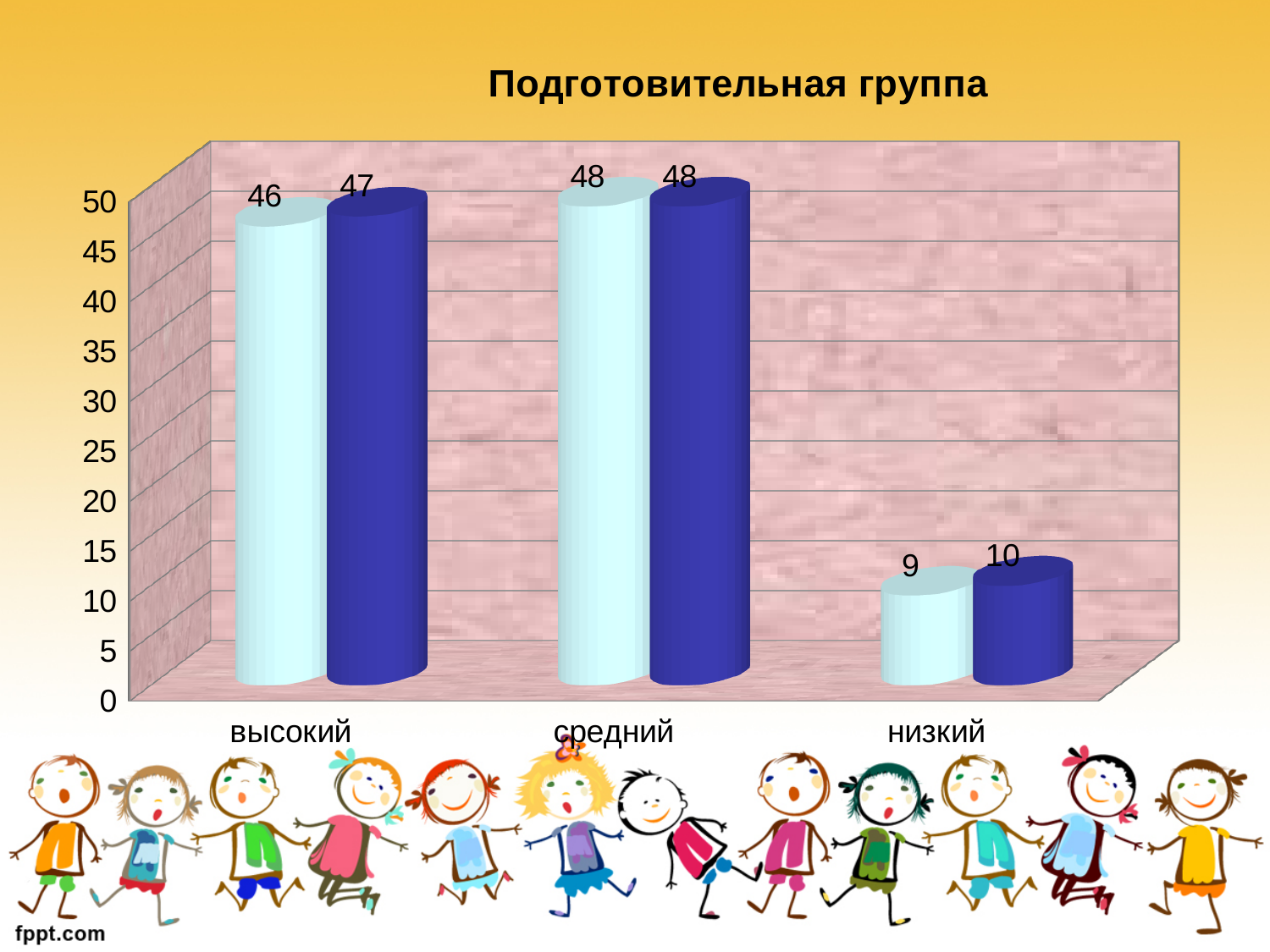
What is the value of the dark blue bar for the category 'высокий'? 47 What is the difference between the dark blue bar for 'средний' and the dark blue bar for 'низкий'? 38 Which is larger: the light blue bar for 'высокий' or the light blue bar for 'низкий'? высокий What kind of chart is shown on the slide? bar chart What is the value of the dark blue bar for the category 'низкий'? 10 How many categories are shown on the x axis of the chart? 3 What is the value of the light blue bar for the category 'низкий'? 9 Which category has the lowest values in the chart? низкий What is the title of the chart? Подготовительная группа What is the value of the light blue bar for the category 'средний'? 48 What is the value of the light blue bar for the category 'высокий'? 46 Which category has the highest values in the chart? средний